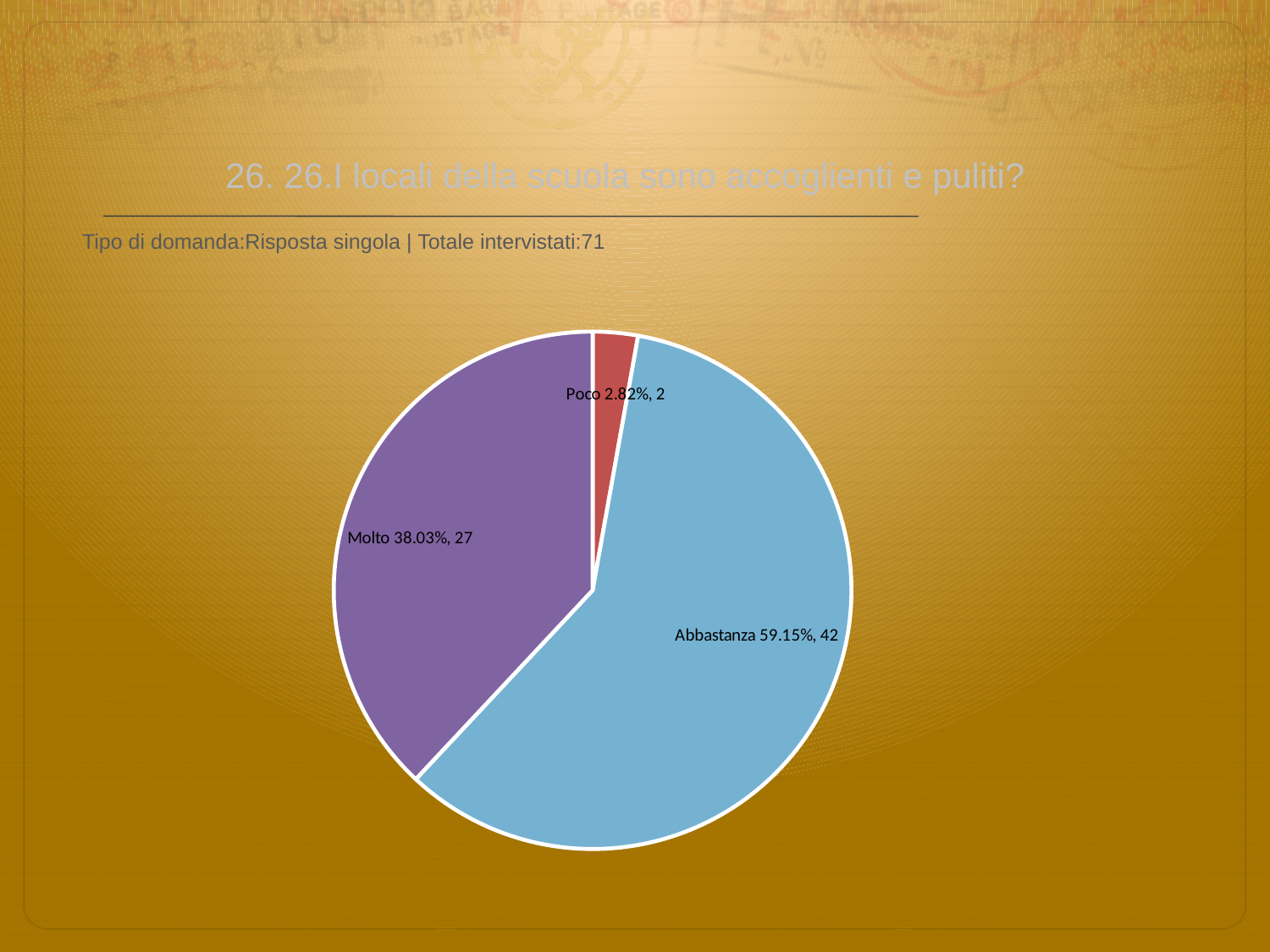
Which response has the smallest slice of the pie? Poco What kind of chart is shown on the slide? pie chart What is the difference in respondent count between Abbastanza and Molto? 15 What percentage share does the Poco slice have? 2.82% What percentage share does the Abbastanza slice have? 59.15% How many respondents answered Poco? 2 Which slice is larger, Molto or Poco? Molto How many respondents answered Abbastanza? 42 Which response has the largest slice of the pie? Abbastanza What percentage share does the Molto slice have? 38.03% How many slices does the pie chart have? 3 How many respondents answered Molto? 27